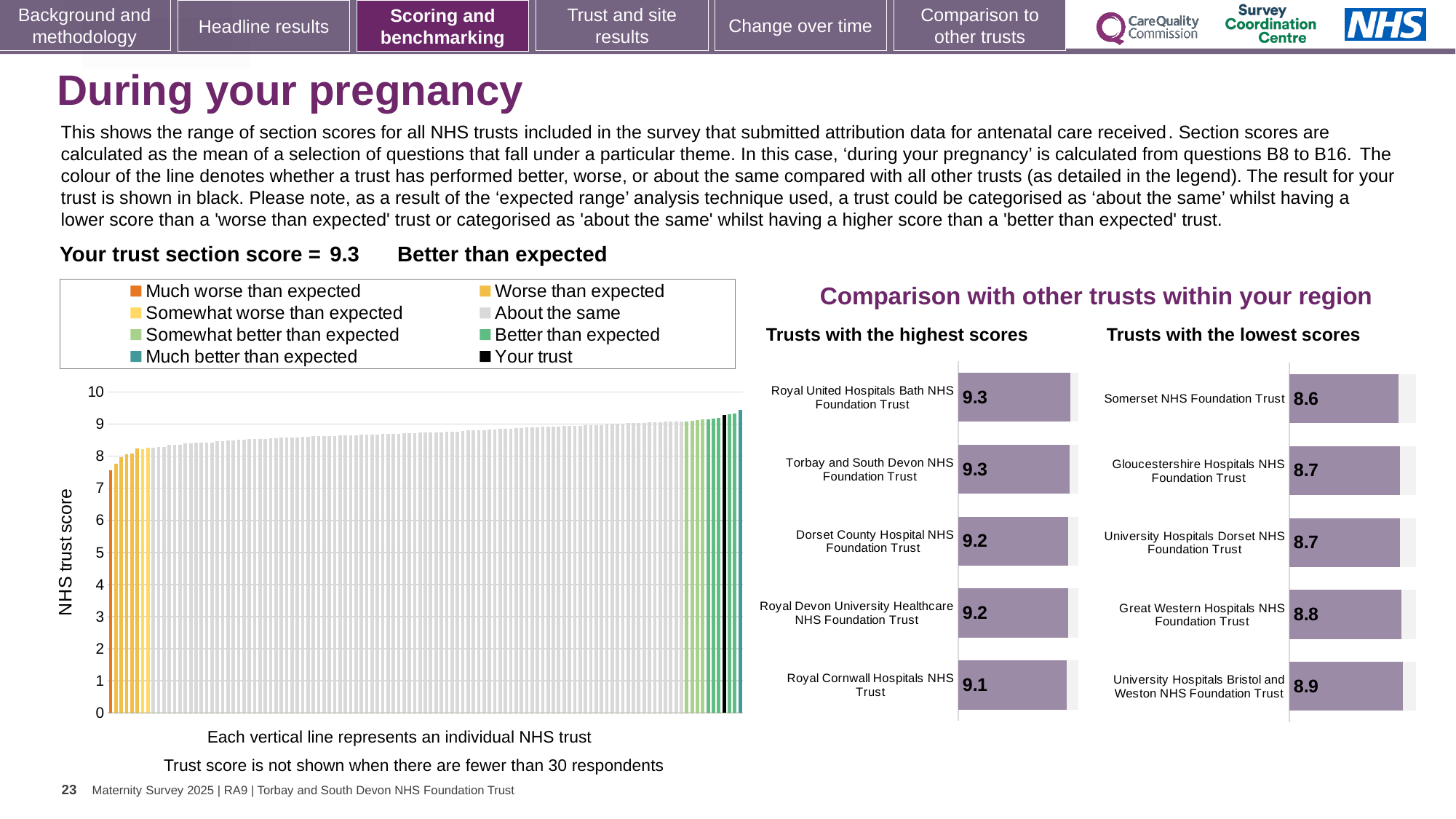
In the large chart on the left showing NHS trust scores, do the values rise or fall from left to right? rise In the 'Trusts with the lowest scores' chart, which trust has the highest score? University Hospitals Bristol and Weston NHS Foundation Trust How many trusts are shown in the 'Trusts with the highest scores' chart? 5 In the 'Trusts with the lowest scores' chart, what is the score for Great Western Hospitals NHS Foundation Trust? 8.8 In the 'Trusts with the lowest scores' chart, what is the score for Somerset NHS Foundation Trust? 8.6 In the 'Trusts with the highest scores' chart, what is the score for Royal Cornwall Hospitals NHS Trust? 9.1 In the 'Trusts with the highest scores' chart, which trust has the lowest score? Royal Cornwall Hospitals NHS Trust In the 'Trusts with the lowest scores' chart, which trust has the lowest score? Somerset NHS Foundation Trust In the 'Trusts with the highest scores' chart, what is the difference between the scores of Royal United Hospitals Bath NHS Foundation Trust and Royal Cornwall Hospitals NHS Trust? 0.2 In the 'Trusts with the lowest scores' chart, which has the larger score: Great Western Hospitals NHS Foundation Trust or Somerset NHS Foundation Trust? Great Western Hospitals NHS Foundation Trust In the 'Trusts with the highest scores' chart, what is the score for Torbay and South Devon NHS Foundation Trust? 9.3 How many entries does the legend of the large chart on the left list? 8